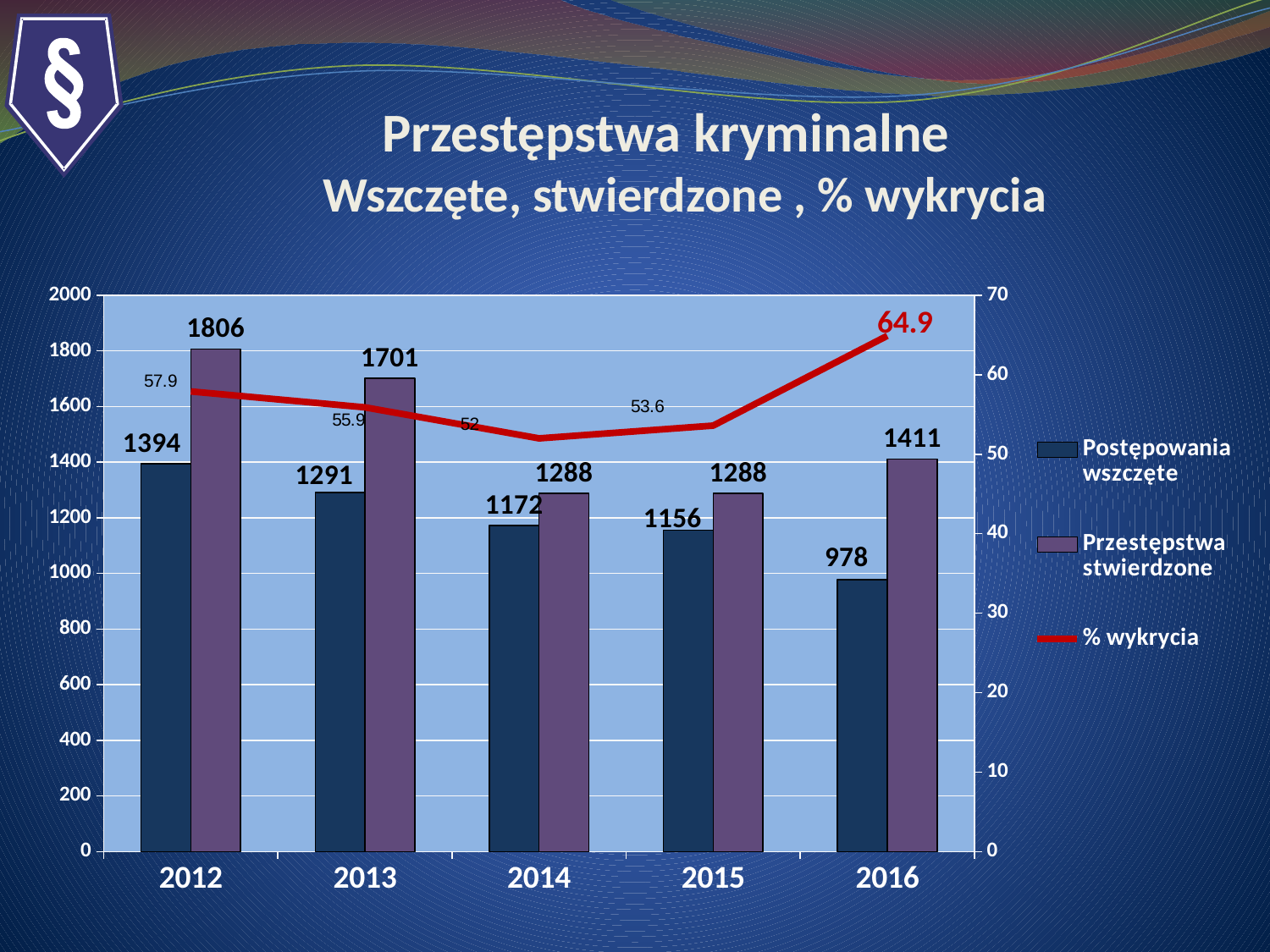
What is the value of Przestępstwa stwierdzone in 2016? 1411 In which year is % wykrycia highest? 2016 In which year is Przestępstwa stwierdzone highest? 2012 What is the value of Postępowania wszczęte in 2012? 1394 How many series does the legend list? 3 Does Postępowania wszczęte rise or fall from 2012 to 2016? Fall What kind of chart is shown on the slide? Combined bar and line chart What is the % wykrycia value for 2014? 52 In which year is Postępowania wszczęte lowest? 2016 Which is larger in 2013: Postępowania wszczęte or Przestępstwa stwierdzone? Przestępstwa stwierdzone What is the difference between Przestępstwa stwierdzone and Postępowania wszczęte in 2016? 433 How many years are shown on the x axis? 5